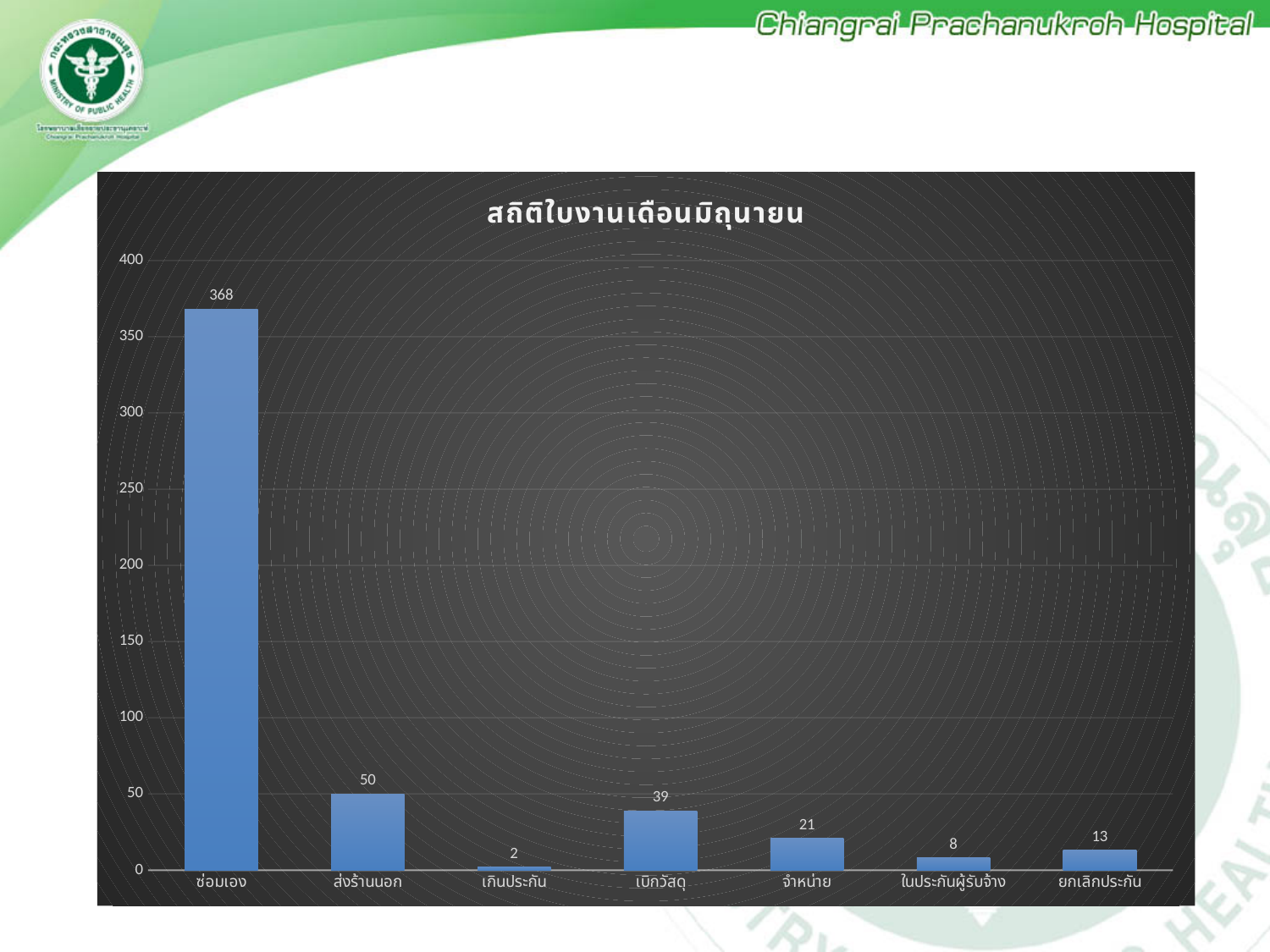
How many categories are shown on the x axis? 7 Which category has the highest value? ซ่อมเอง What is the difference between the values for ซ่อมเอง and ส่งร้านนอก? 318 What is the difference between the values for จำหน่าย and ในประกันผู้รับจ้าง? 13 What is the value for เบิกวัสดุ? 39 What is the value for ซ่อมเอง? 368 Which category has the lowest value? เกินประกัน Which is larger, the value for เบิกวัสดุ or the value for จำหน่าย? เบิกวัสดุ What kind of chart is shown on the slide? bar chart What is the value for ยกเลิกประกัน? 13 What is the value for ส่งร้านนอก? 50 Is the value for ซ่อมเอง greater or less than 350? greater